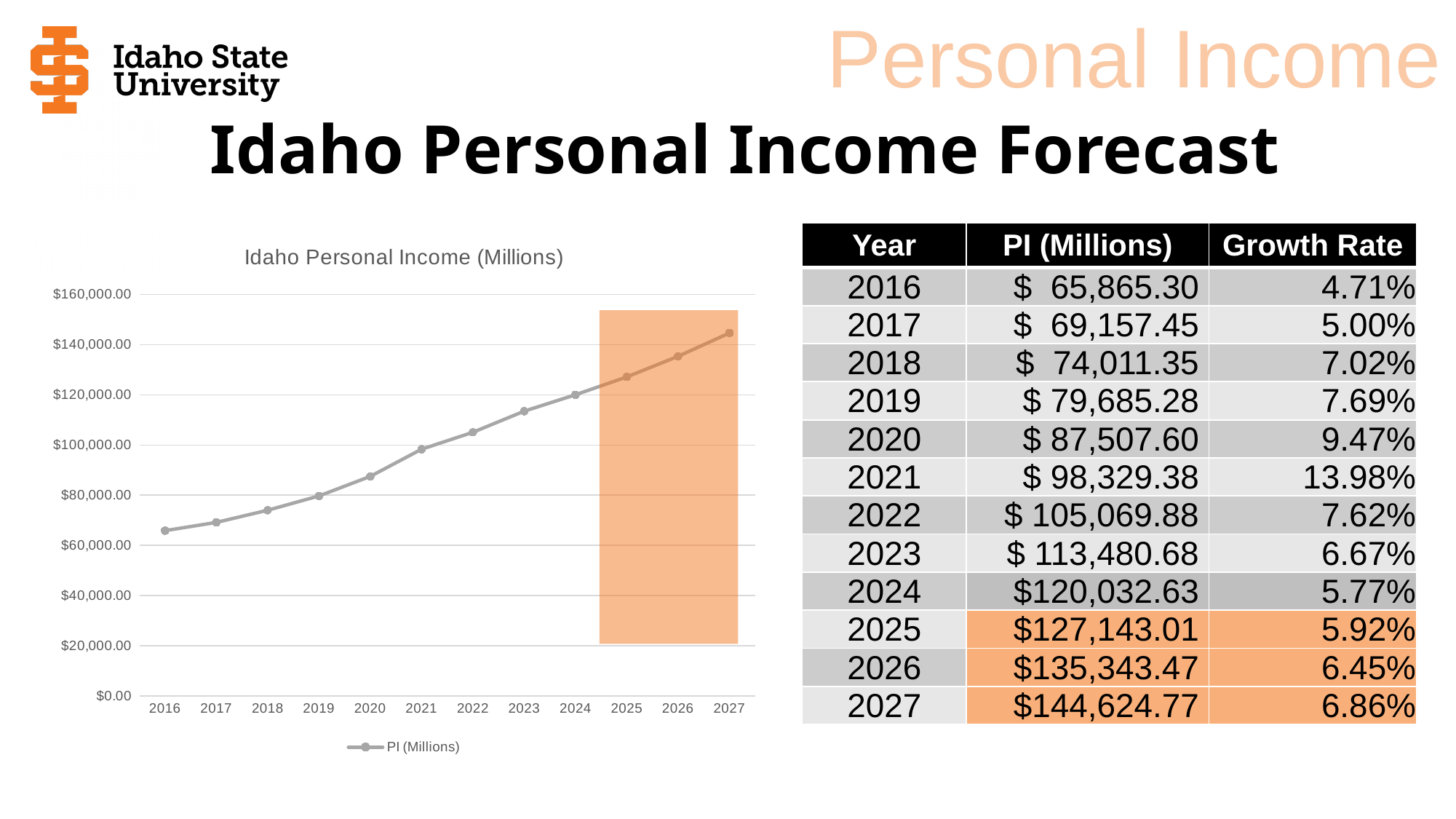
How many years are plotted along the x axis of the chart? 12 How many series does the chart's legend list? 1 Which years on the chart are highlighted with an orange shaded area? 2025, 2026, 2027 Do the PI (Millions) values rise or fall from 2016 to 2027? rise What is the title of the chart on the slide? Idaho Personal Income (Millions) What kind of chart is the "Idaho Personal Income (Millions)" chart? line chart Which year has the highest PI (Millions) value? 2027 According to the slide, what is the PI (Millions) value for 2027? $144,624.77 Which year has the lowest PI (Millions) value? 2016 Which year has the larger PI (Millions) value, 2019 or 2023? 2023 Is the PI (Millions) value for 2021 greater or less than $100,000.00? less Is the PI (Millions) value for 2024 greater or less than $100,000.00? greater